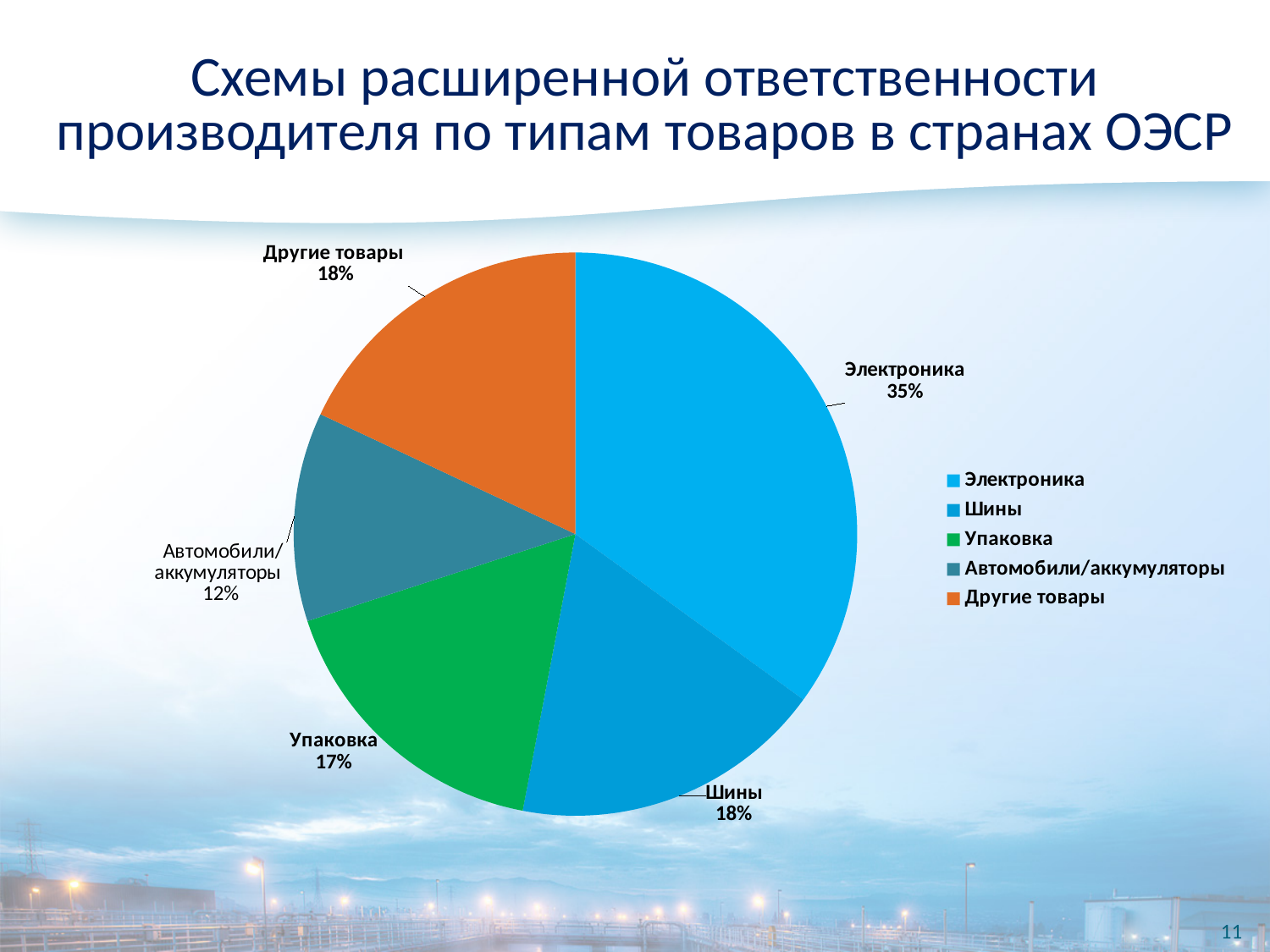
How many entries does the legend list? 5 Which category has the smallest slice of the pie? Автомобили/аккумуляторы What is the value shown for Автомобили/аккумуляторы? 12% How many categories are shown in the pie chart? 5 What share of the pie does Электроника account for? 35% What kind of chart is shown on the slide? Pie chart What is the value shown for Шины? 18% What is the value shown for Упаковка? 17% Which is larger, the share for Шины or the share for Упаковка? Шины Which category has the largest slice of the pie? Электроника What is the value shown for Другие товары? 18% What is the difference in percentage points between Электроника and Шины? 17